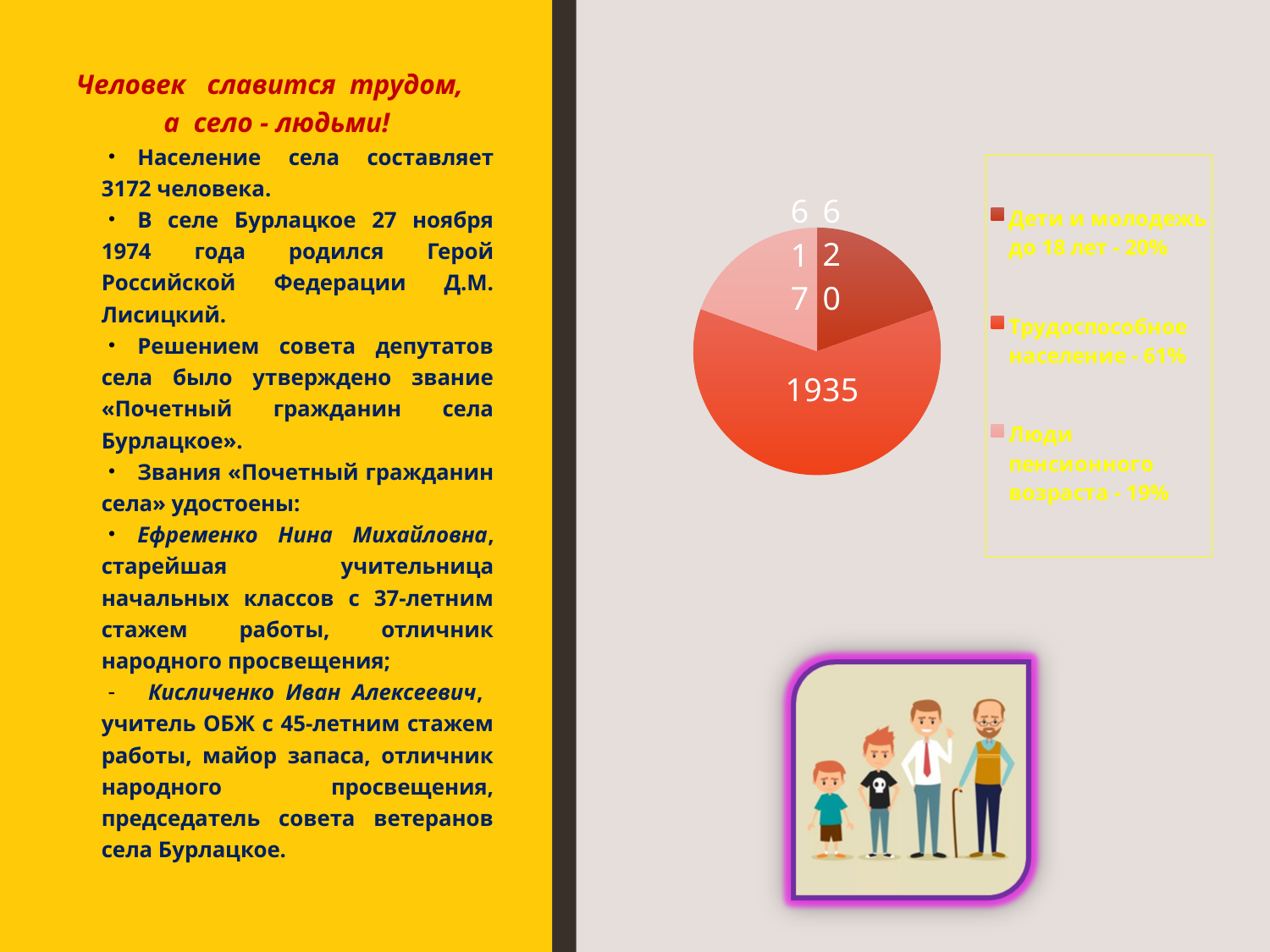
What colour is the largest slice of the pie chart? red What percentage does the legend give for Дети и молодежь до 18 лет? 20% What value is printed on the largest slice of the pie chart? 1935 What percentage does the legend give for Люди пенсионного возраста? 19% What is the difference between the largest slice value (1935) and the slice labelled 620? 1315 What is the total of the three values printed on the pie chart (617, 620 and 1935)? 3172 What percentage does the legend give for Трудоспособное население? 61% How many slices does the pie chart have? 3 According to the legend, which share is larger: Дети и молодежь до 18 лет or Люди пенсионного возраста? Дети и молодежь до 18 лет Which legend category has the largest slice in the pie chart? Трудоспособное население How many entries does the legend of the pie chart list? 3 What kind of chart is shown on the slide? pie chart